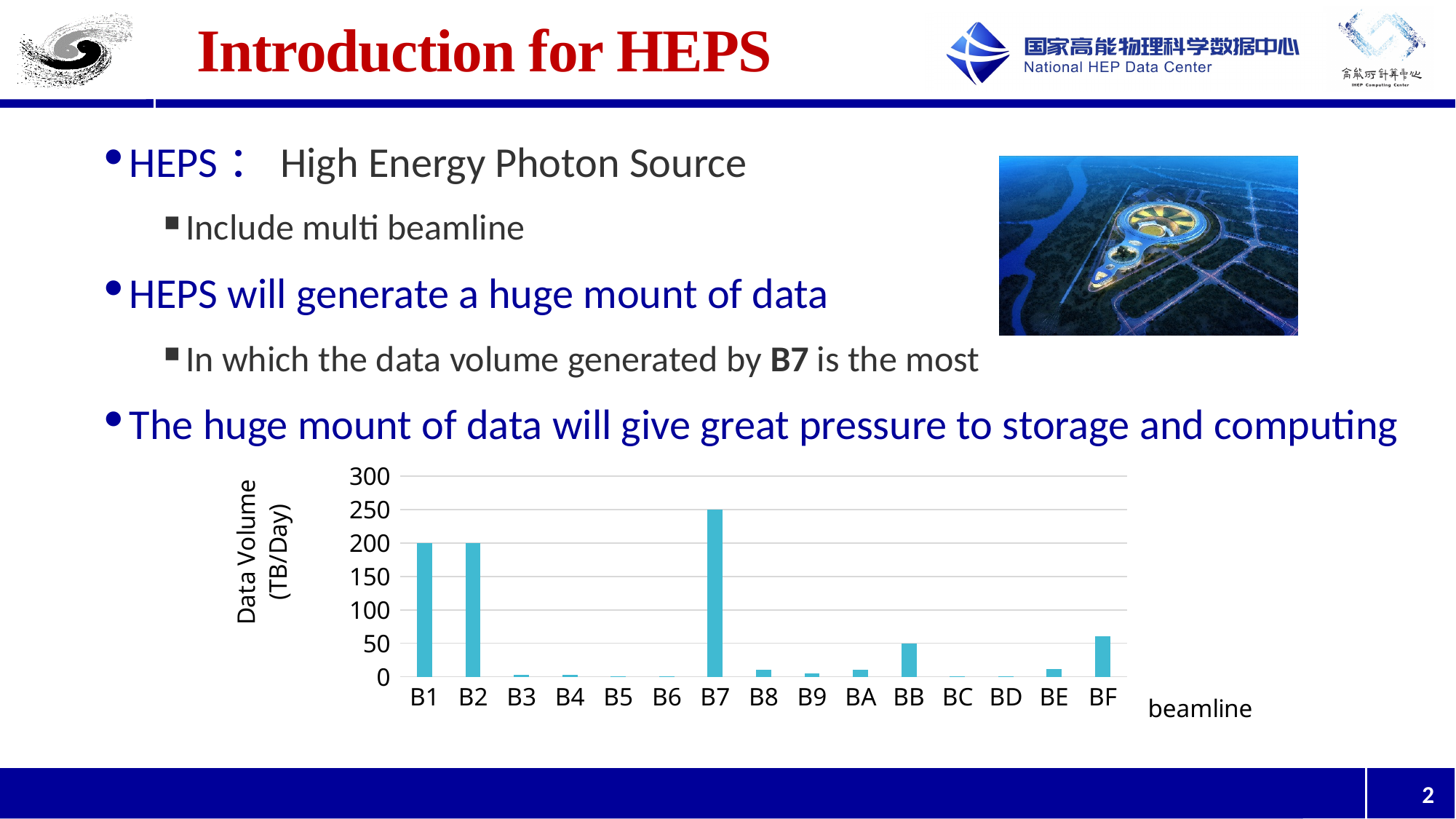
What is the data volume for B7 in the chart? 250 What is the data volume for B1 in the chart? 200 How many beamlines are shown on the x axis of the chart? 15 Which beamline has the highest data volume in the chart? B7 What is the label of the y axis of the chart? Data Volume (TB/Day) Is the data volume for B8 greater or less than 50? less What is the difference in data volume between B7 and B1? 50 What is the data volume for BB in the chart? 50 Is the data volume for BF greater or less than 50? greater What is the label of the x axis of the chart? beamline What kind of chart is shown on the slide? bar chart Which has a larger data volume, B7 or B2? B7